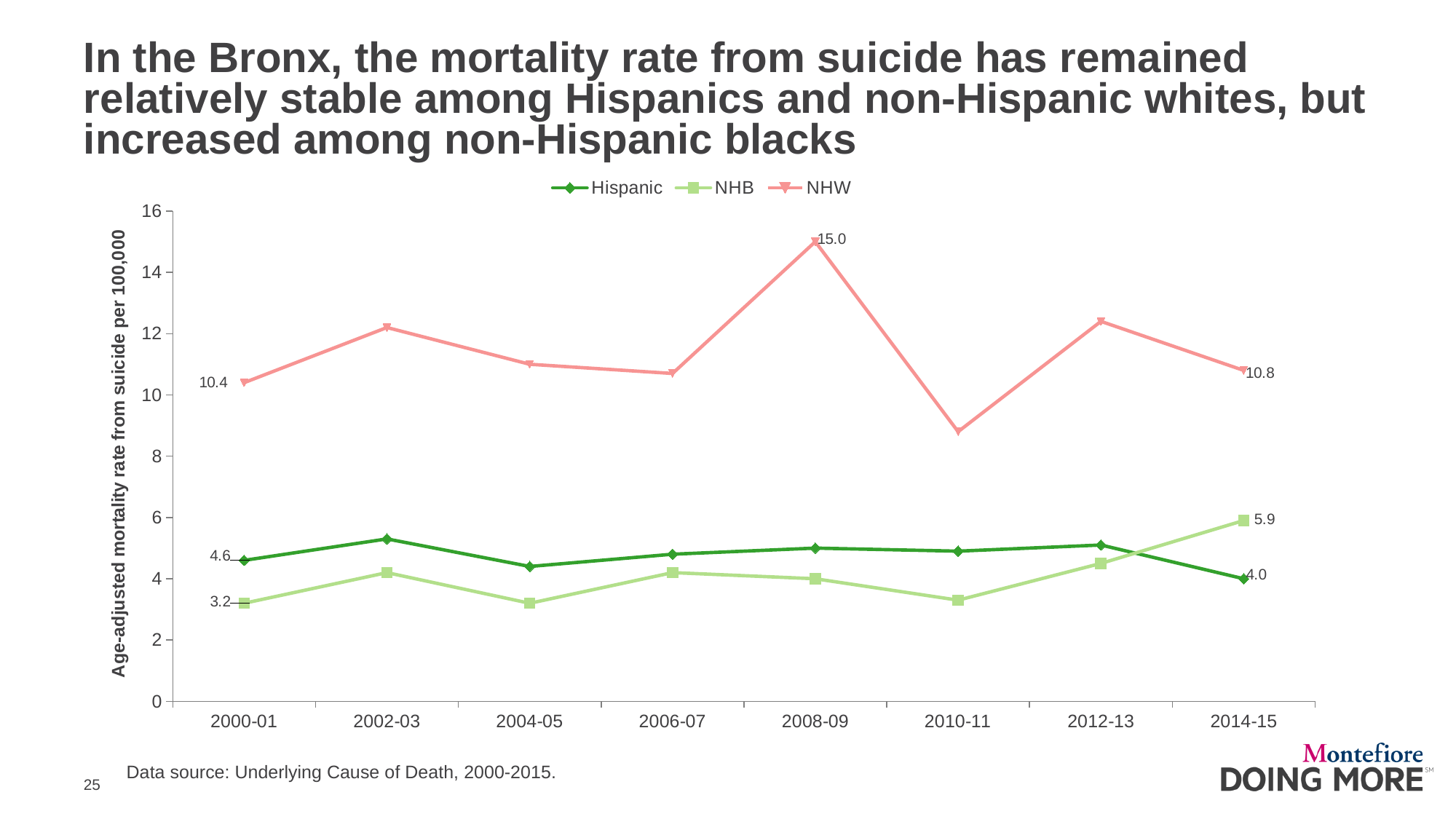
Is the NHW value for 2010-11 greater or less than 10? less What is the NHW mortality rate in 2008-09? 15.0 What is the NHB mortality rate in 2014-15? 5.9 How many time periods are shown on the x axis? 8 What is the difference between the NHB rate in 2014-15 and in 2000-01? 2.7 Which series has the lowest value in 2000-01? NHB Which is larger in 2014-15, the Hispanic rate or the NHB rate? NHB What kind of chart is shown on the slide? line chart What is the NHW mortality rate in 2000-01? 10.4 What is the Hispanic mortality rate in 2000-01? 4.6 In which period does the NHW series reach its highest value? 2008-09 How many series does the legend list? 3